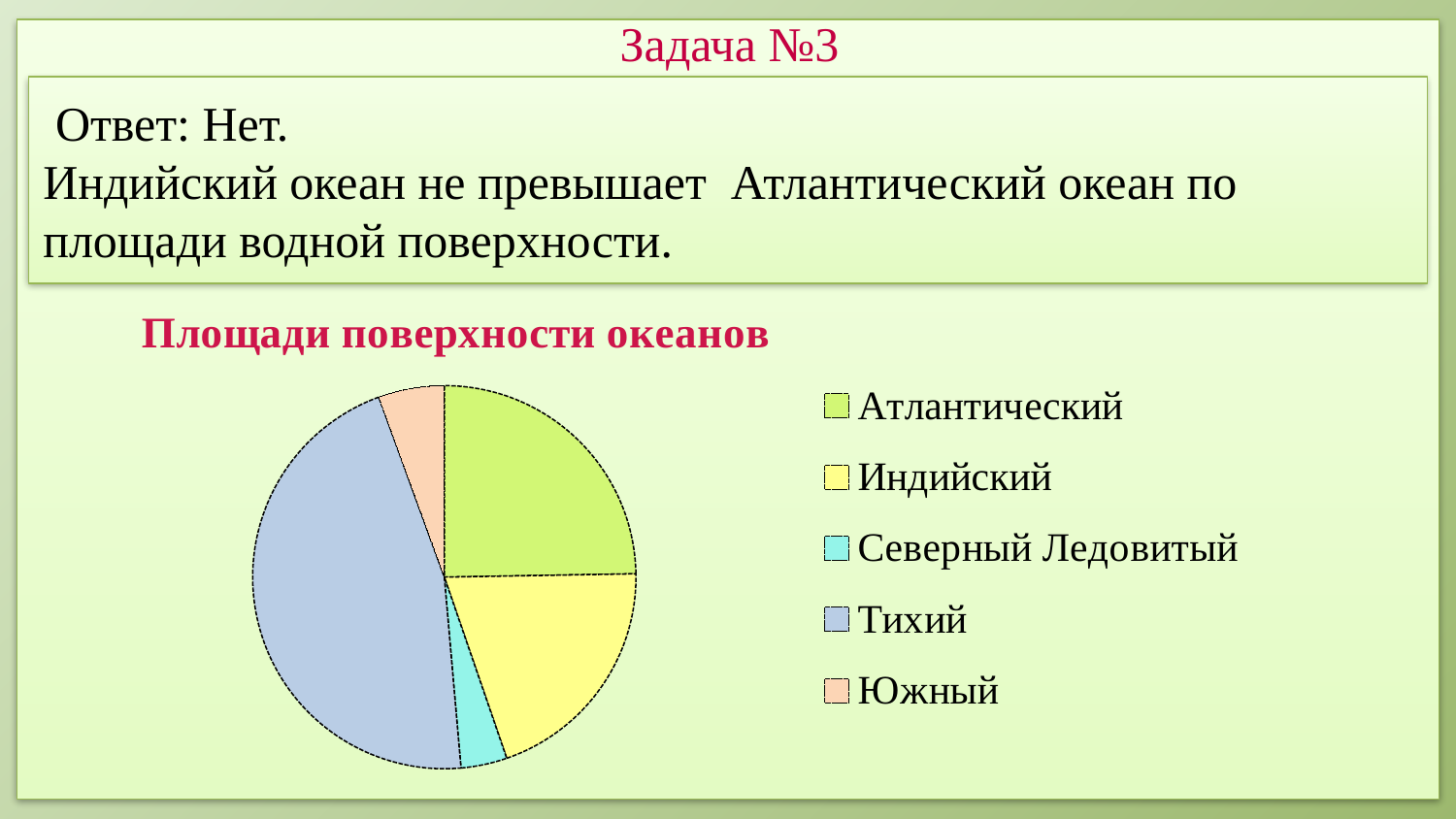
How many entries does the legend list? 5 Which slice is larger, Индийский or Южный? Индийский Which ocean has the largest slice in the pie chart? Тихий How many slices does the pie chart have? 5 Which slice is larger, Тихий or Индийский? Тихий Which slice is larger, Тихий or Атлантический? Тихий What is the title of the chart? Площади поверхности океанов What kind of chart is shown on the slide? pie chart Which ocean has the smallest slice in the pie chart? Северный Ледовитый Which colour represents Тихий in the pie chart? blue